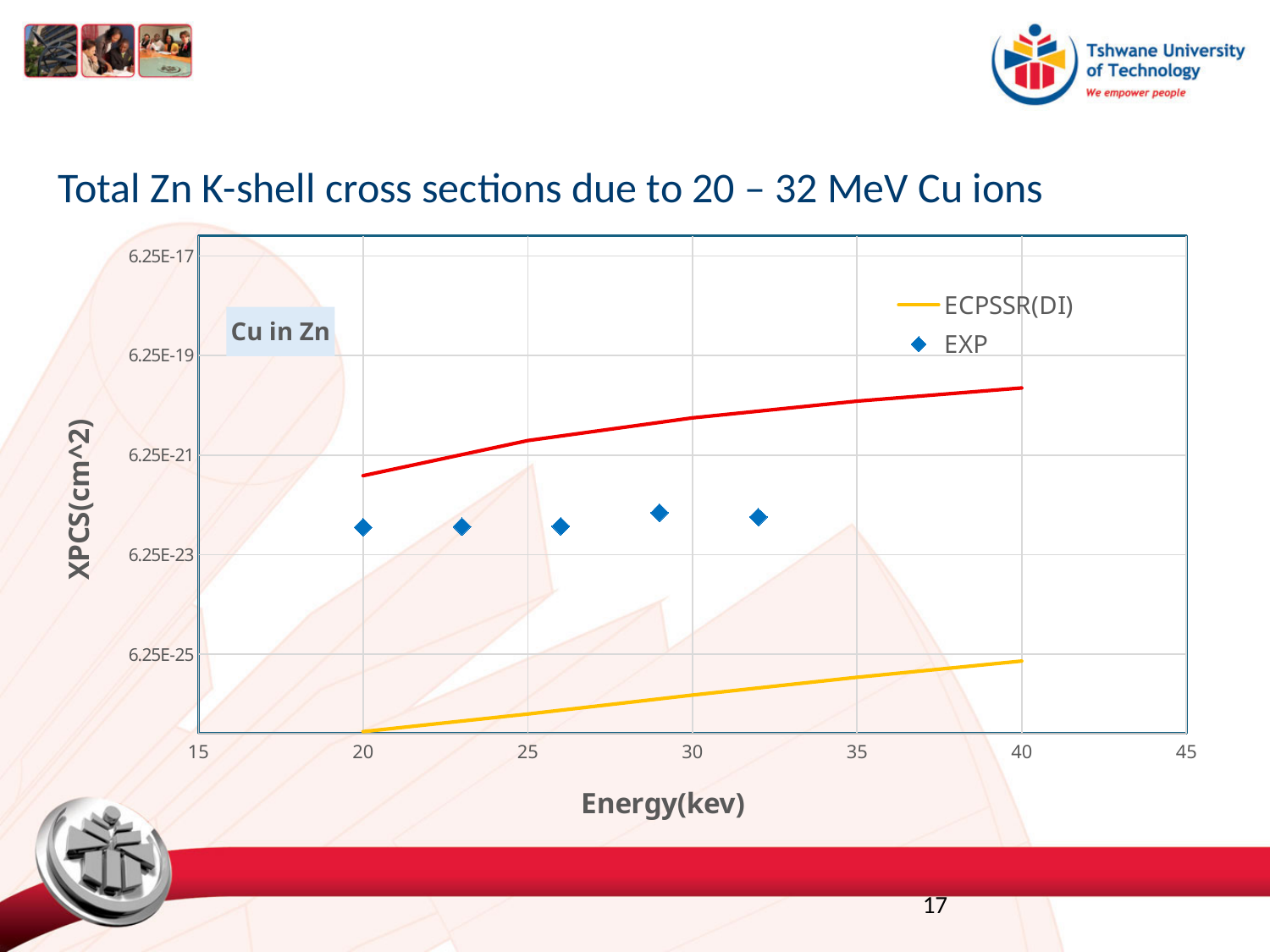
What is the label of the x axis? Energy(kev) What is the title of the chart? Cu in Zn Which EXP point has the lowest energy on the x axis? 20 Is the EXP value at 20 keV greater or less than 6.25E-21? less How many EXP data points are plotted on the chart? 5 How many series does the chart legend list? 2 Is the EXP value at 29 keV greater or less than 6.25E-21? less At 40 keV, which is larger, the red line or the ECPSSR(DI) line? the red line Does the ECPSSR(DI) line rise or fall as energy increases from 20 to 40 keV? rise Which is larger, the EXP value at 29 keV or the EXP value at 20 keV? EXP at 29 keV Is the EXP value at 20 keV greater or less than 6.25E-23? greater